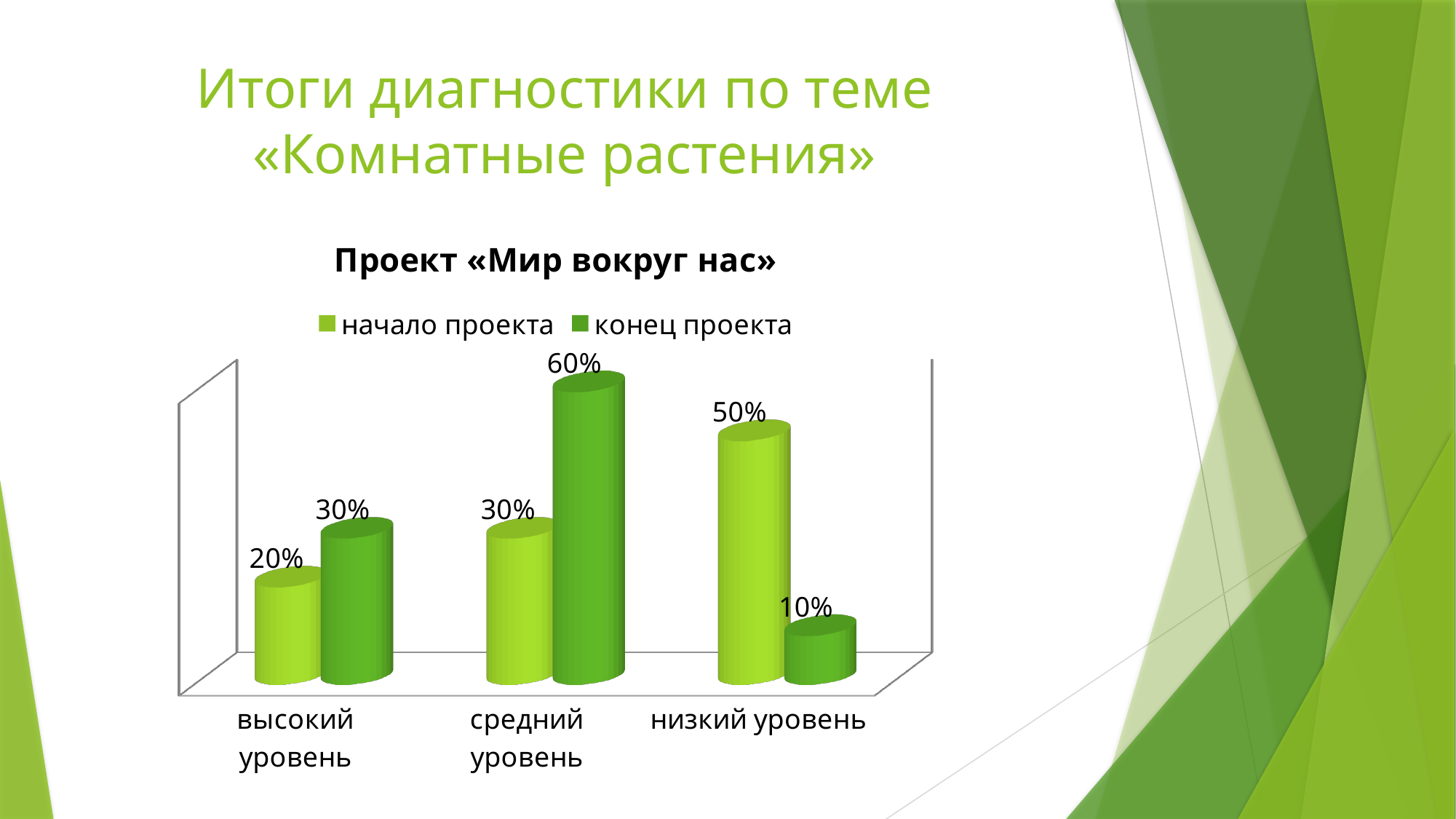
Which category has the lowest value in the "начало проекта" series? высокий уровень What is the value for "высокий уровень" in the "начало проекта" series? 20% Which category has the highest value in the "конец проекта" series? средний уровень What is the difference between the "начало проекта" and "конец проекта" values for "низкий уровень"? 40% How many series does the legend list? 2 What is the value for "низкий уровень" in the "начало проекта" series? 50% What is the value for "низкий уровень" in the "конец проекта" series? 10% What is the value for "средний уровень" in the "конец проекта" series? 60% For "средний уровень", which series has the larger value: "начало проекта" or "конец проекта"? конец проекта How many categories are shown on the x axis? 3 What is the value for "высокий уровень" in the "конец проекта" series? 30% What is the title of the chart? Проект «Мир вокруг нас»